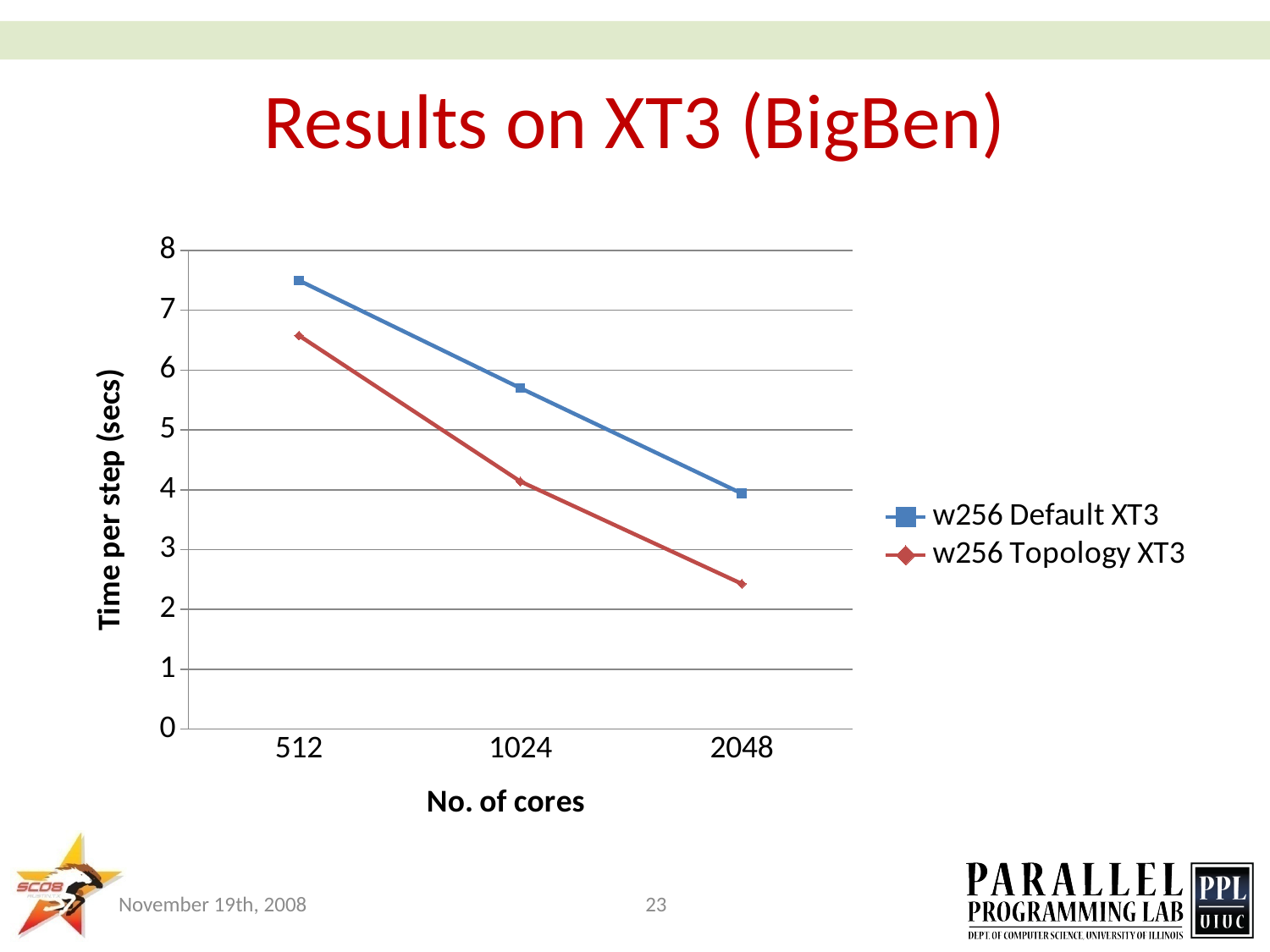
Is the value for w256 Default XT3 at 512 cores greater or less than 7? greater Do the values for w256 Default XT3 rise or fall as the number of cores increases? fall What kind of chart is shown on the slide? line chart Is the value for w256 Topology XT3 at 512 cores greater or less than 6? greater How many core counts are plotted along the x axis? 3 At which number of cores is the time per step for w256 Topology XT3 highest? 512 What is the label of the y axis? Time per step (secs) At 2048 cores, which series has the larger time per step, w256 Default XT3 or w256 Topology XT3? w256 Default XT3 How many series does the legend list? 2 At which number of cores is the time per step for w256 Default XT3 lowest? 2048 Is the value for w256 Default XT3 at 1024 cores greater or less than 5? greater